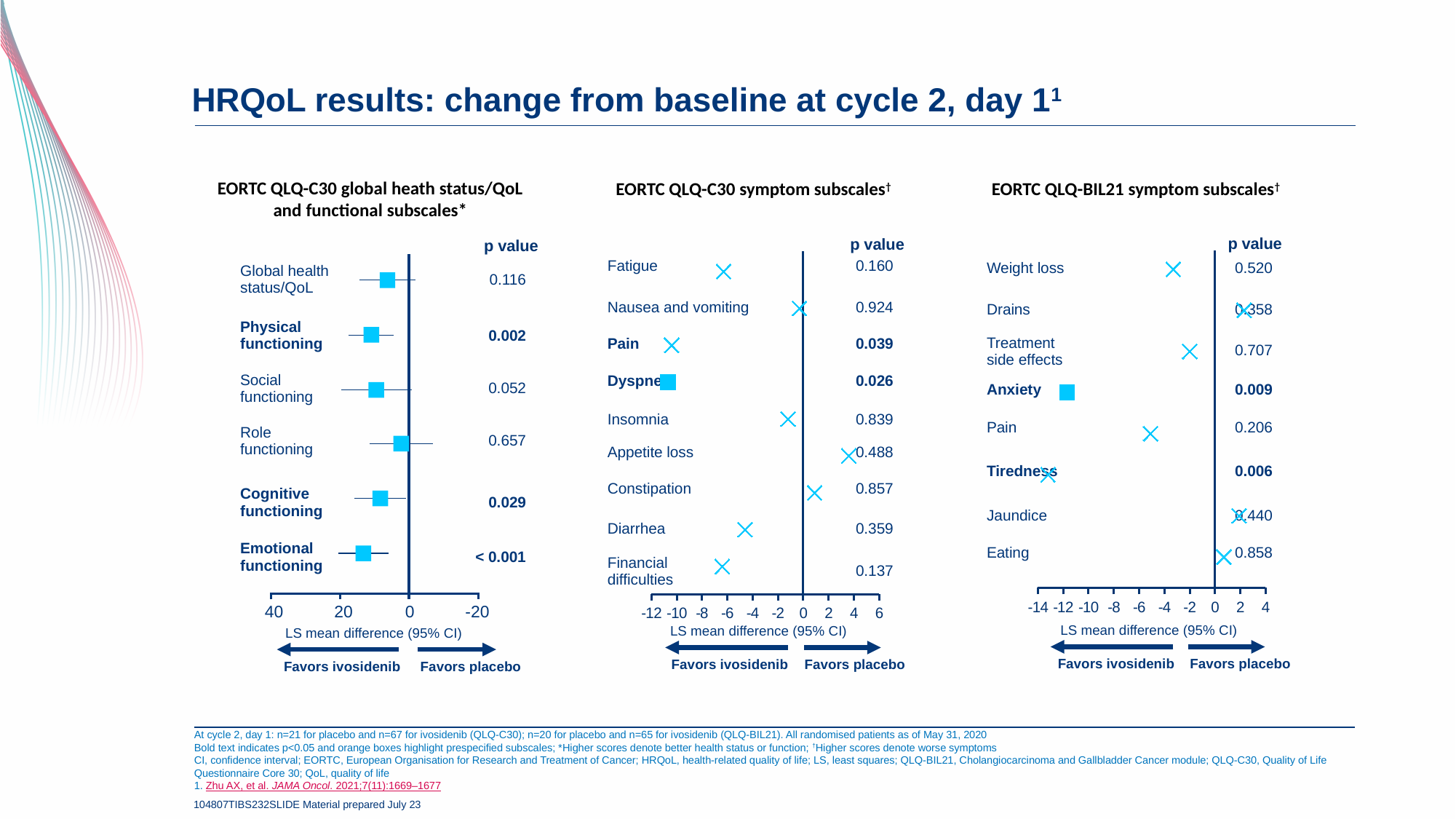
In the EORTC QLQ-C30 global health status/QoL and functional subscales chart, what is the p value for Emotional functioning? < 0.001 In the EORTC QLQ-C30 symptom subscales chart, is the LS mean difference for Pain greater or less than -6? less In the EORTC QLQ-BIL21 symptom subscales chart, what is the p value for Anxiety? 0.009 In the EORTC QLQ-C30 symptom subscales chart, which symptom has the highest p value? Nausea and vomiting How many symptom subscales are plotted in the EORTC QLQ-C30 symptom subscales chart? 9 In the EORTC QLQ-C30 global health status/QoL and functional subscales chart, which subscale has the highest p value? Role functioning In the EORTC QLQ-BIL21 symptom subscales chart, what is the difference between the p values for Weight loss and Pain? 0.314 In the EORTC QLQ-C30 symptom subscales chart, what is the p value for Dyspnea? 0.026 In the EORTC QLQ-C30 symptom subscales chart, which symptom has the lowest p value? Dyspnea In the EORTC QLQ-C30 global health status/QoL and functional subscales chart, what is the p value for Physical functioning? 0.002 How many subscales are plotted in the EORTC QLQ-C30 global health status/QoL and functional subscales chart? 6 In the EORTC QLQ-BIL21 symptom subscales chart, which symptom has the lowest p value? Tiredness